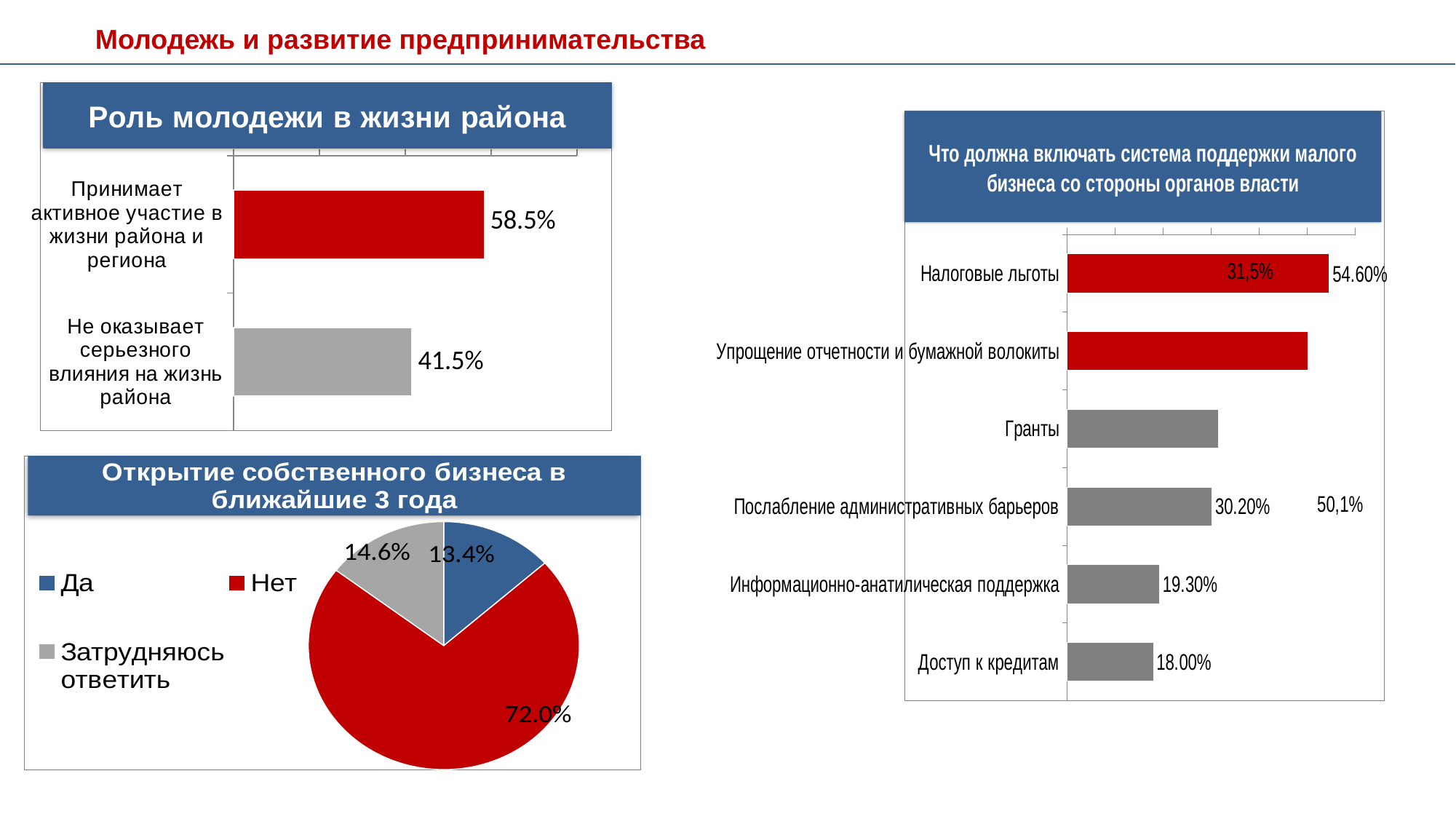
In the chart 'Роль молодежи в жизни района', what is the difference between the two bars? 17.0% In the pie chart 'Открытие собственного бизнеса в ближайшие 3 года', what is the value for 'Да'? 13.4% In the chart 'Роль молодежи в жизни района', what is the value for 'Не оказывает серьезного влияния на жизнь района'? 41.5% How many entries does the legend of the pie chart 'Открытие собственного бизнеса в ближайшие 3 года' list? 3 In the chart 'Что должна включать система поддержки малого бизнеса со стороны органов власти', which category has the longest bar? Налоговые льготы In the chart 'Что должна включать система поддержки малого бизнеса со стороны органов власти', what is the value for 'Доступ к кредитам'? 18.00% In the chart 'Что должна включать система поддержки малого бизнеса со стороны органов власти', what is the value for 'Информационно-анатилическая поддержка'? 19.30% In the chart 'Роль молодежи в жизни района', what is the value for 'Принимает активное участие в жизни района и региона'? 58.5% In the pie chart 'Открытие собственного бизнеса в ближайшие 3 года', which slice is the smallest? Да In the pie chart 'Открытие собственного бизнеса в ближайшие 3 года', what share does 'Нет' have? 72.0% What kind of chart is 'Роль молодежи в жизни района'? bar chart How many categories are shown in the chart 'Что должна включать система поддержки малого бизнеса со стороны органов власти'? 6